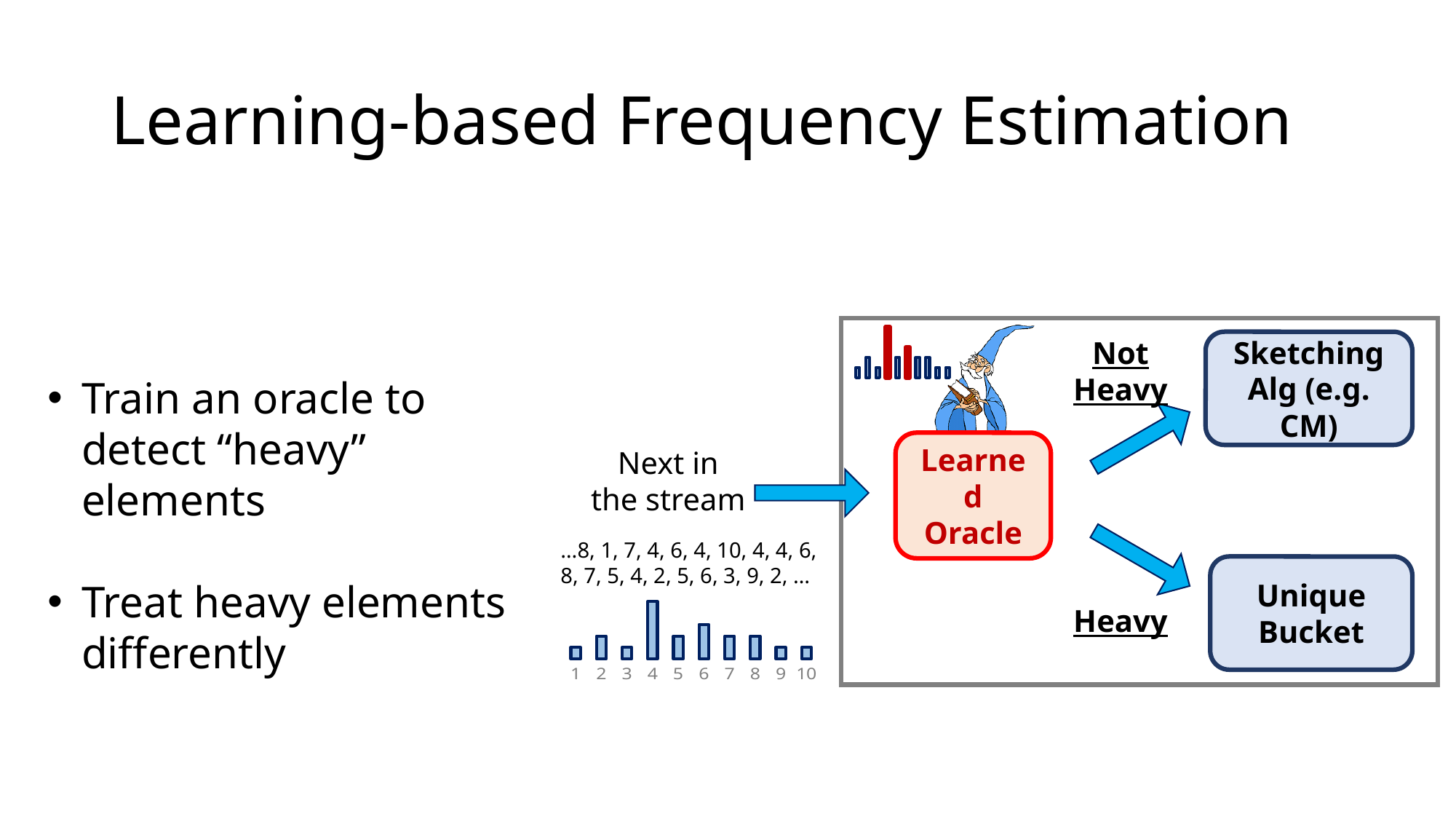
In the bar chart below the stream of numbers, is the bar for category 4 taller or shorter than the bar for category 6? taller In the bar chart below the stream of numbers, is the bar for category 1 taller or shorter than the bar for category 6? shorter How many categories does the bar chart below the stream of numbers have? 10 In the bar chart below the stream of numbers, is the bar for category 8 taller or shorter than the bar for category 9? taller What are the category labels along the x axis of the bar chart below the stream of numbers? 1 through 10 What kind of chart is shown below the stream of numbers on the slide? bar chart In the bar chart below the stream of numbers, which category has the tallest bar? 4 Does the bar chart below the stream of numbers show a legend? No